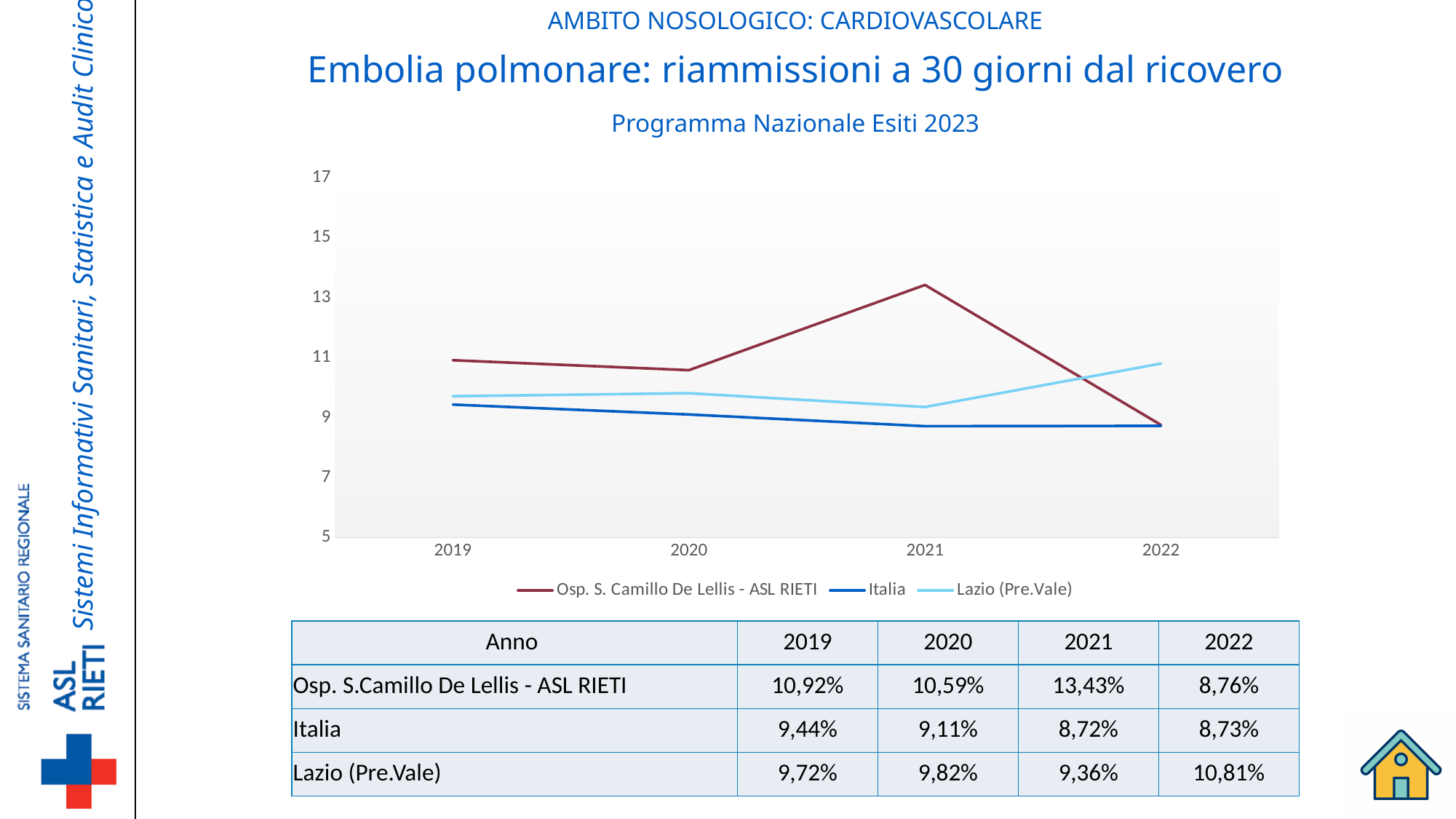
In which year does the Osp. S. Camillo De Lellis - ASL RIETI series have its lowest value? 2022 In which year does the Osp. S. Camillo De Lellis - ASL RIETI series reach its highest value? 2021 Does the Italia series rise or fall from 2019 to 2021? fall In 2022, which is larger: the value for Lazio (Pre.Vale) or the value for Osp. S. Camillo De Lellis - ASL RIETI? Lazio (Pre.Vale) What is the difference between the Osp. S. Camillo De Lellis - ASL RIETI value and the Italia value in 2021? 4,71 percentage points What is the value for Italia in 2019? 9,44% How many years are plotted along the x axis of the chart? 4 What type of chart is shown on the slide? line chart Is the value for Osp. S. Camillo De Lellis - ASL RIETI in 2021 greater or less than 13? greater What is the value for Osp. S. Camillo De Lellis - ASL RIETI in 2021? 13,43% How many series does the chart legend list? 3 What is the value for Lazio (Pre.Vale) in 2022? 10,81%